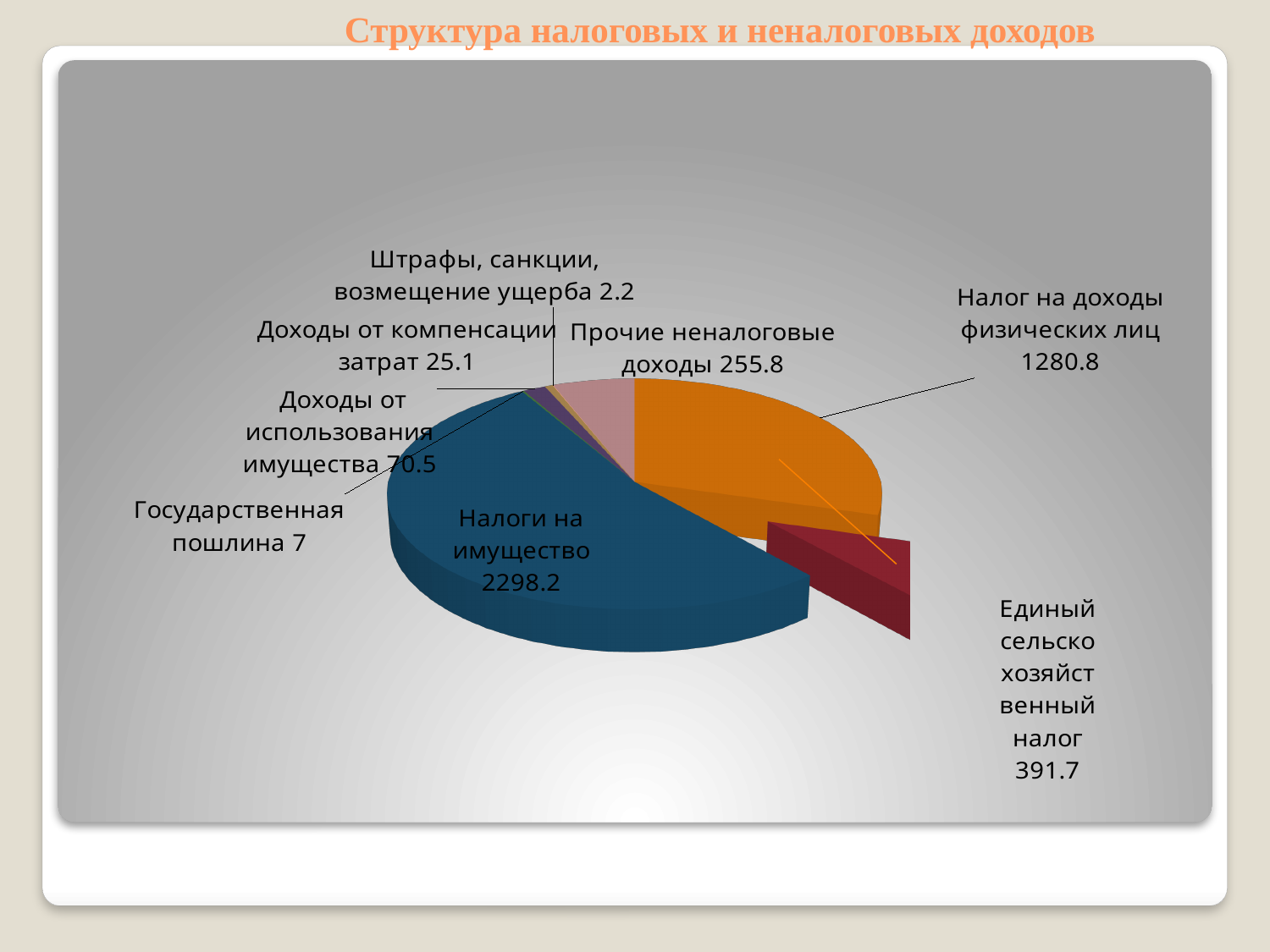
What is the difference between Единый сельскохозяйственный налог and Прочие неналоговые доходы? 135.9 What is the value for Налог на доходы физических лиц? 1280.8 What is the difference between Налоги на имущество and Налог на доходы физических лиц? 1017.4 What type of chart is shown on the slide? Pie chart Which is larger: Доходы от использования имущества or Доходы от компенсации затрат? Доходы от использования имущества What is the title of the slide's chart? Структура налоговых и неналоговых доходов Which category has the smallest value? Штрафы, санкции, возмещение ущерба What is the value for Налоги на имущество? 2298.2 What is the value for Единый сельскохозяйственный налог? 391.7 What is the value for Государственная пошлина? 7 How many categories does the pie chart show? 8 Which category has the largest slice of the pie? Налоги на имущество